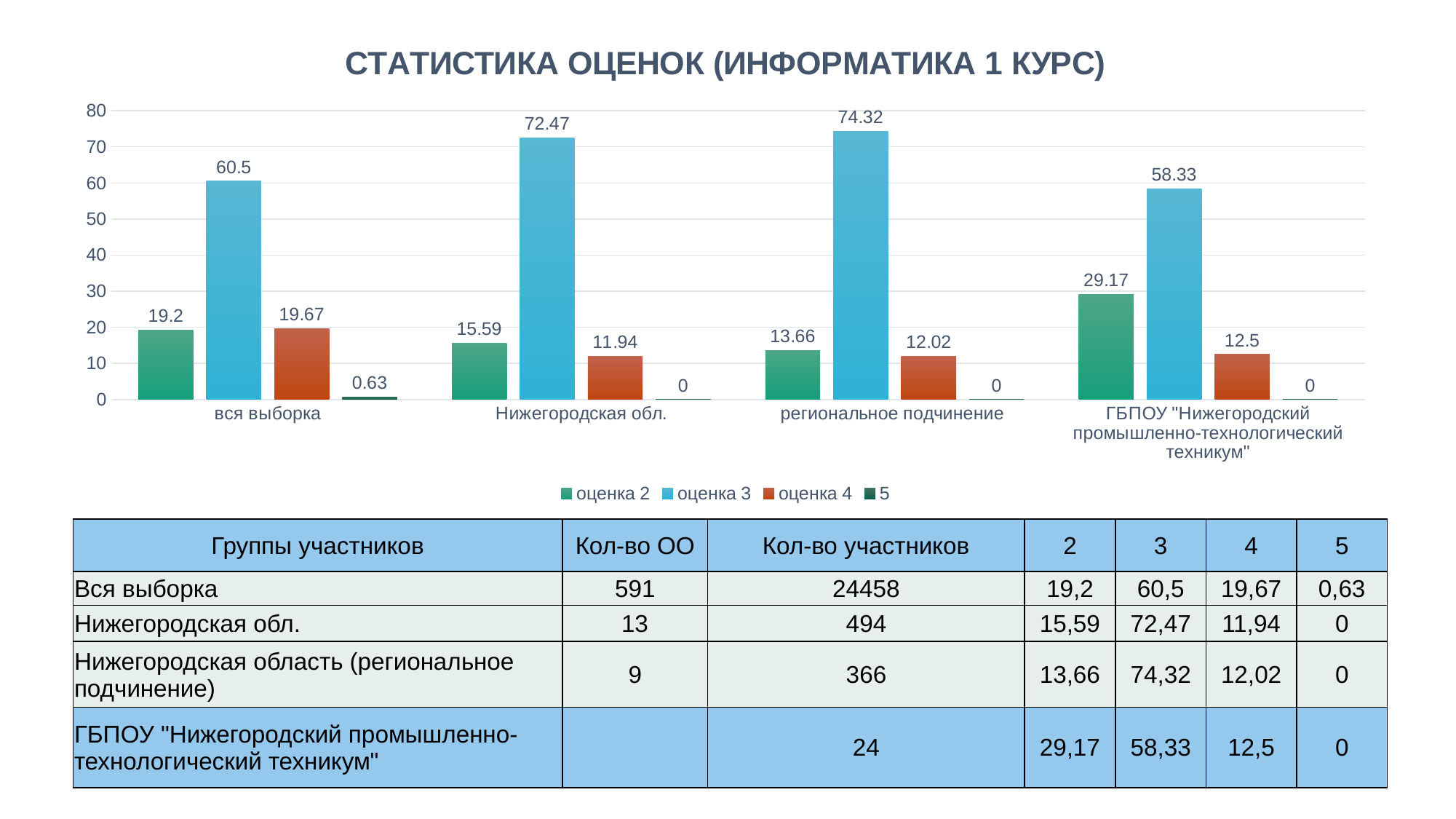
What is the value of оценка 2 for ГБПОУ "Нижегородский промышленно-технологический техникум"? 29.17 Which category has the highest value for оценка 3? региональное подчинение How many series does the legend list? 4 What is the title of the chart? СТАТИСТИКА ОЦЕНОК (ИНФОРМАТИКА 1 КУРС) How many categories are shown on the x axis of the chart? 4 Which is larger: оценка 4 for вся выборка or оценка 4 for ГБПОУ "Нижегородский промышленно-технологический техникум"? вся выборка What is the difference between оценка 3 and оценка 2 for вся выборка? 41.3 What is the value of series 5 for вся выборка? 0.63 What kind of chart is shown on the slide? bar chart What is the value of оценка 3 for Нижегородская обл.? 72.47 Which category has the lowest value for оценка 2? региональное подчинение Is the value of оценка 3 for ГБПОУ "Нижегородский промышленно-технологический техникум" greater or less than 50? greater